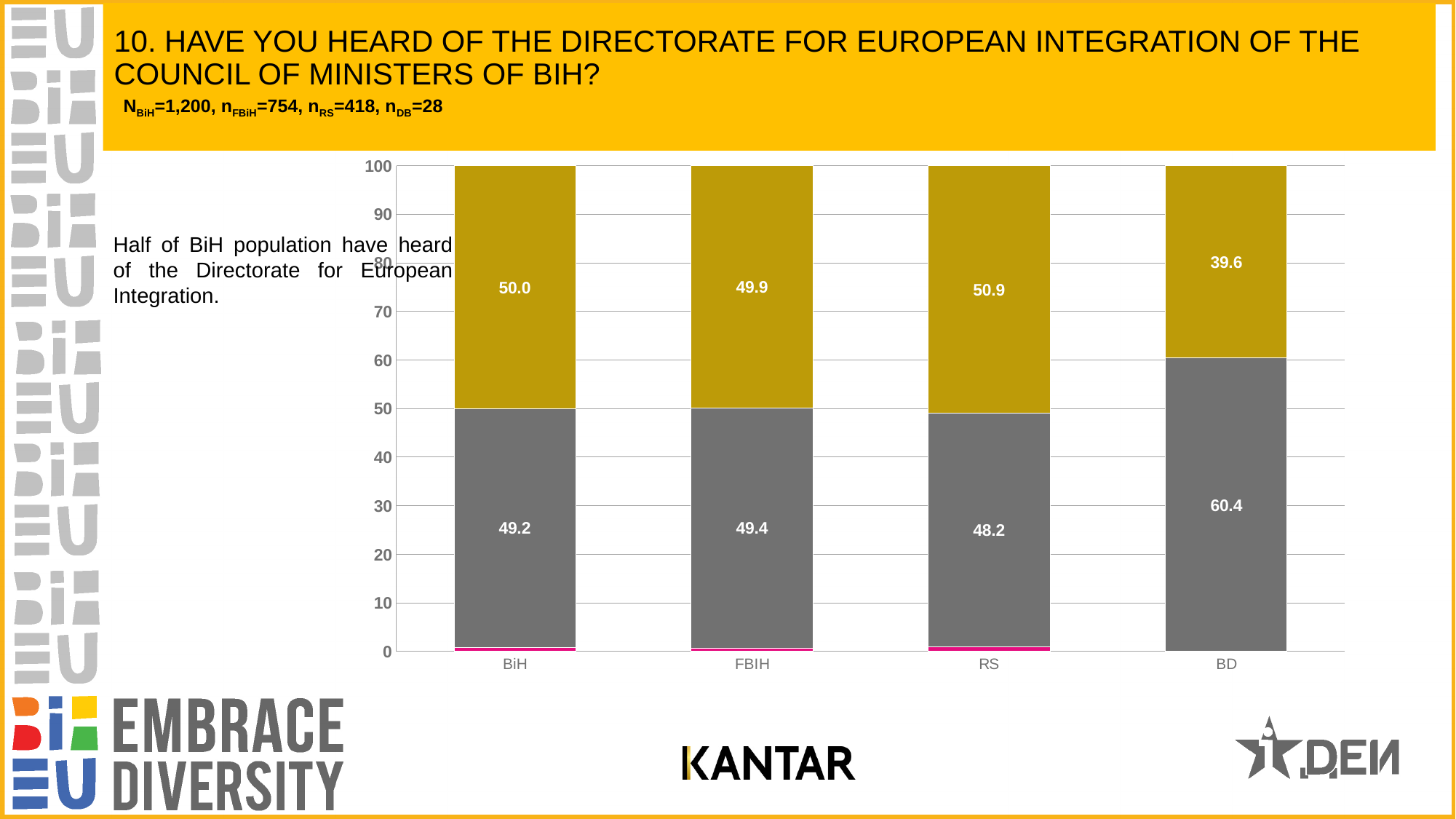
What is the maximum value shown on the y axis of the chart? 100 What is the difference between the grey segment values for BD and RS? 12.2 What type of chart is shown on the slide? stacked bar chart What is the value of the grey segment for BD? 60.4 How many categories are shown on the x axis of the chart? 4 What is the value of the gold (top) segment for RS? 50.9 What is the value of the grey segment for FBIH? 49.4 Is the gold (top) segment value larger for RS or for BD? RS Is the grey segment value for BD greater or less than 50? greater Which category has the highest grey segment value? BD Which category has the lowest gold (top) segment value? BD What is the value of the gold (top) segment for BiH? 50.0